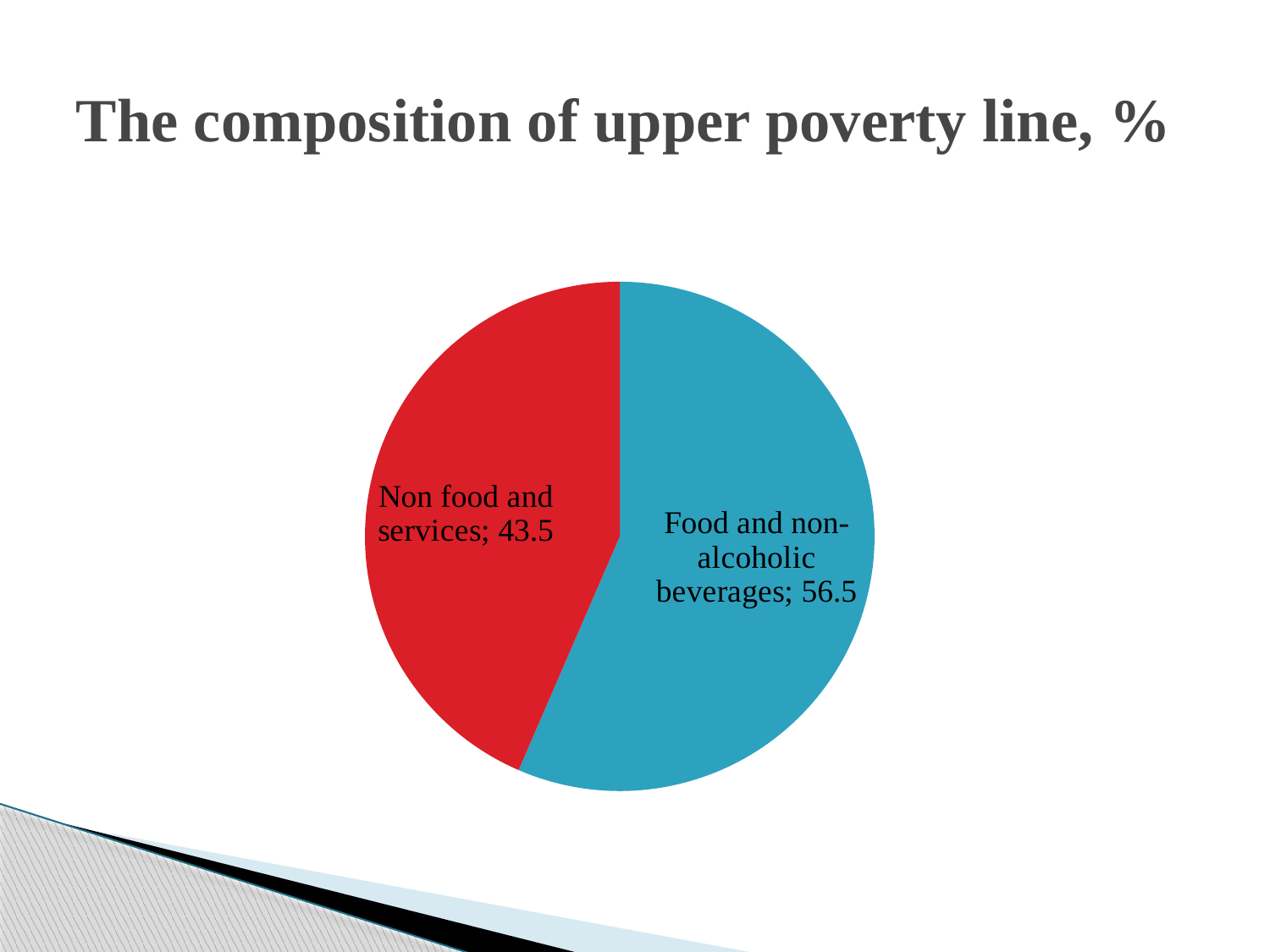
What is the value for Non food and services? 43.5 How many slices does the pie chart have? 2 What is the value for Food and non-alcoholic beverages? 56.5 Which slice is the smallest? Non food and services What is the title of the slide? The composition of upper poverty line, % Which is larger, Food and non-alcoholic beverages or Non food and services? Food and non-alcoholic beverages What is the difference between the Food and non-alcoholic beverages value and the Non food and services value? 13 What is the total of the two slice values? 100 What colour is the Non food and services slice? Red What kind of chart is shown on the slide? Pie chart What share of the pie does Non food and services represent? 43.5% Which slice is the largest? Food and non-alcoholic beverages